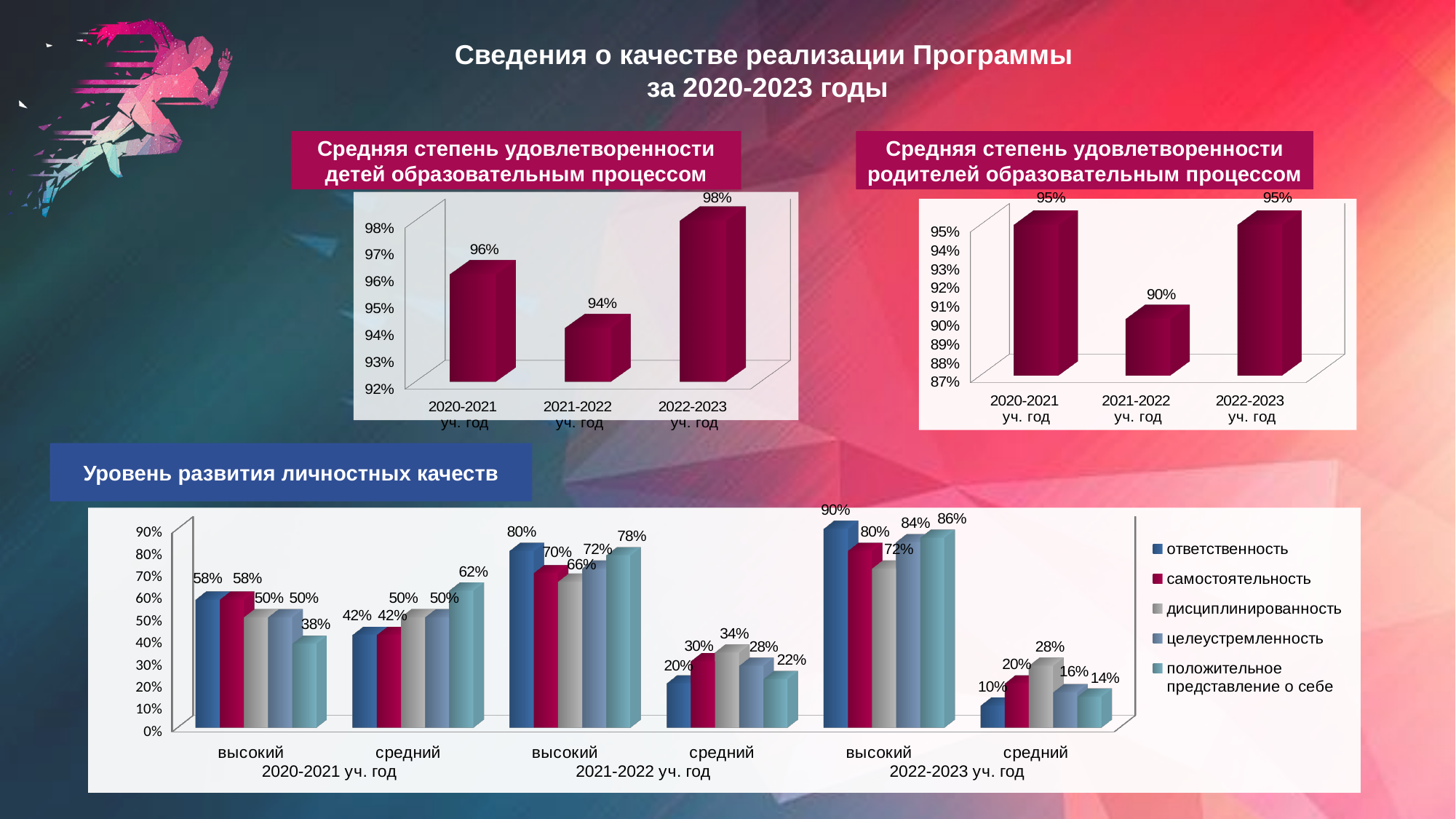
In the chart 'Уровень развития личностных качеств', which is larger for высокий in 2021-2022 уч. год: 'самостоятельность' or 'целеустремленность'? целеустремленность In the chart 'Средняя степень удовлетворенности родителей образовательным процессом', what is the value for 2021-2022 уч. год? 90% In the chart 'Уровень развития личностных качеств', what is the value of 'положительное представление о себе' for средний in 2020-2021 уч. год? 62% In the chart 'Средняя степень удовлетворенности родителей образовательным процессом', how many bars are plotted? 3 In the chart 'Средняя степень удовлетворенности детей образовательным процессом', what is the difference between the 2022-2023 and 2020-2021 values? 2% How many series does the legend of the chart 'Уровень развития личностных качеств' list? 5 In the chart 'Уровень развития личностных качеств', what is the value of 'ответственность' for высокий in 2022-2023 уч. год? 90% What type of chart is 'Уровень развития личностных качеств'? Bar chart In the chart 'Средняя степень удовлетворенности детей образовательным процессом', what is the value for 2021-2022 уч. год? 94% In the chart 'Средняя степень удовлетворенности детей образовательным процессом', which year has the highest value? 2022-2023 уч. год In the chart 'Уровень развития личностных качеств', how does the 'ответственность' value for высокий change from 2020-2021 to 2022-2023? It rises In the chart 'Средняя степень удовлетворенности родителей образовательным процессом', which year has the lowest value? 2021-2022 уч. год